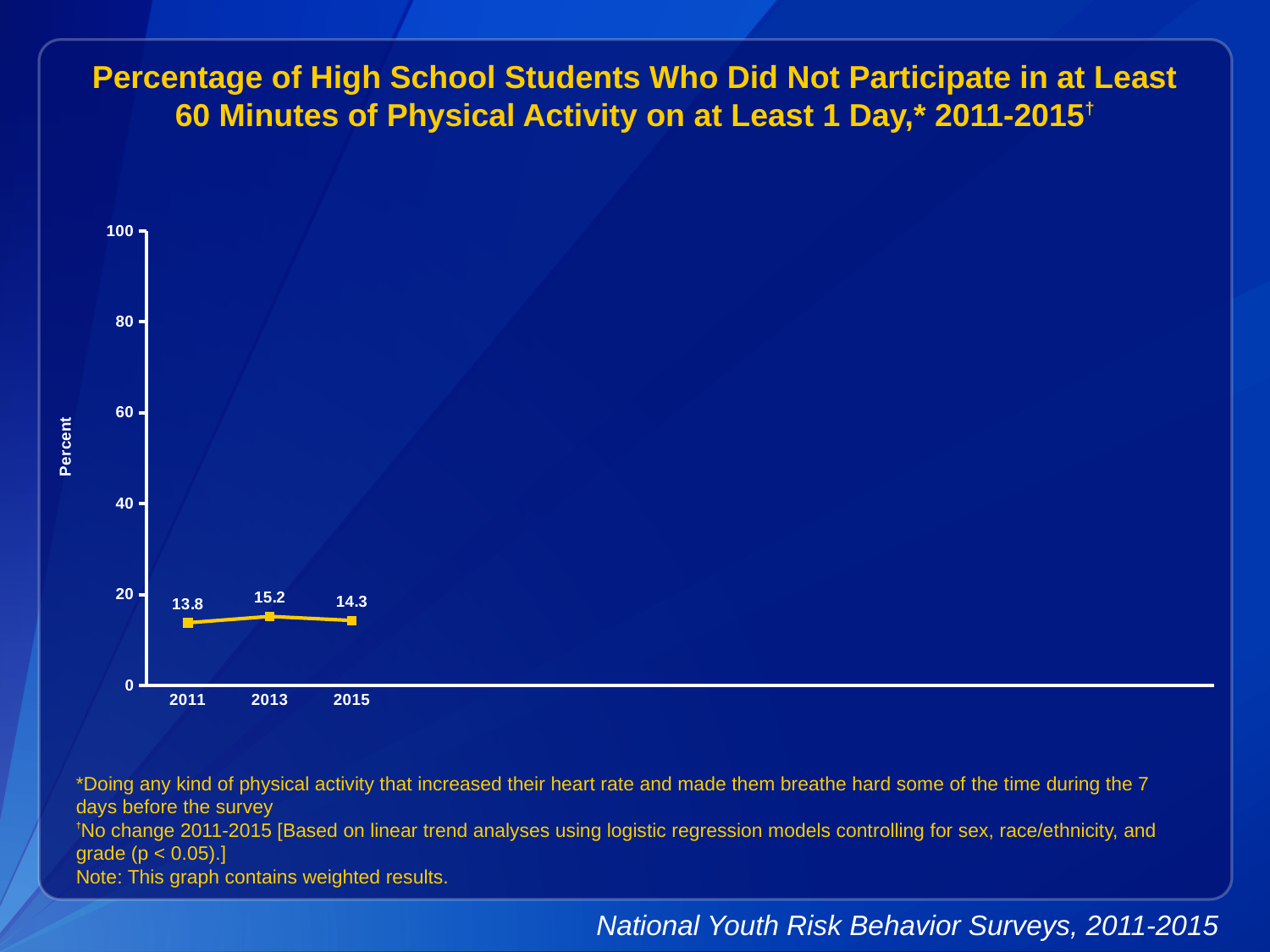
Which is larger, the value for 2015 or the value for 2011? 2015 Which year has the highest value? 2013 What is the value for 2011? 13.8 What is the label of the y axis? Percent What is the value for 2015? 14.3 Is the value for 2013 greater or less than 20? less What is the difference between the values for 2013 and 2011? 1.4 Which year has the lowest value? 2011 What kind of chart is shown on the slide? line chart How many years are plotted on the chart? 3 What is the difference between the values for 2013 and 2015? 0.9 What is the value for 2013? 15.2